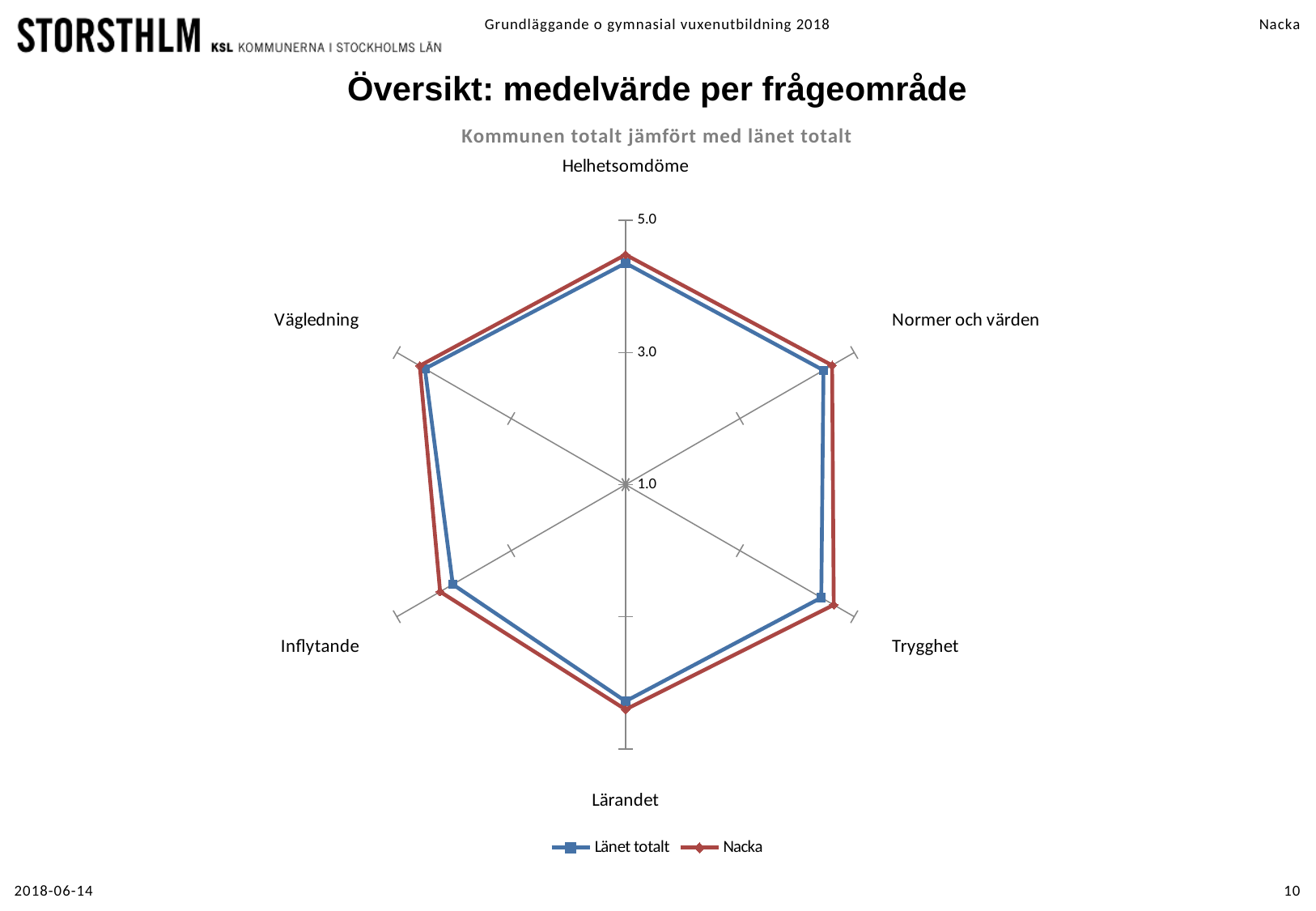
What kind of chart is shown on the slide? Radar chart For Trygghet, which series has the higher value, Länet totalt or Nacka? Nacka Is the value for Trygghet for Nacka greater or less than 3.0? greater What is the title of the chart? Översikt: medelvärde per frågeområde Which category has the lowest value for Länet totalt? Inflytande Is the value for Inflytande for Länet totalt greater or less than 3.0? greater Is the value for Helhetsomdöme for Nacka greater or less than 5.0? less Which two series are shown in the legend? Länet totalt and Nacka What is the highest value shown on the chart's axis scale? 5.0 For Inflytande, which series has the higher value, Länet totalt or Nacka? Nacka How many categories (question areas) are plotted on the radar chart? 6 How many series does the legend list? 2